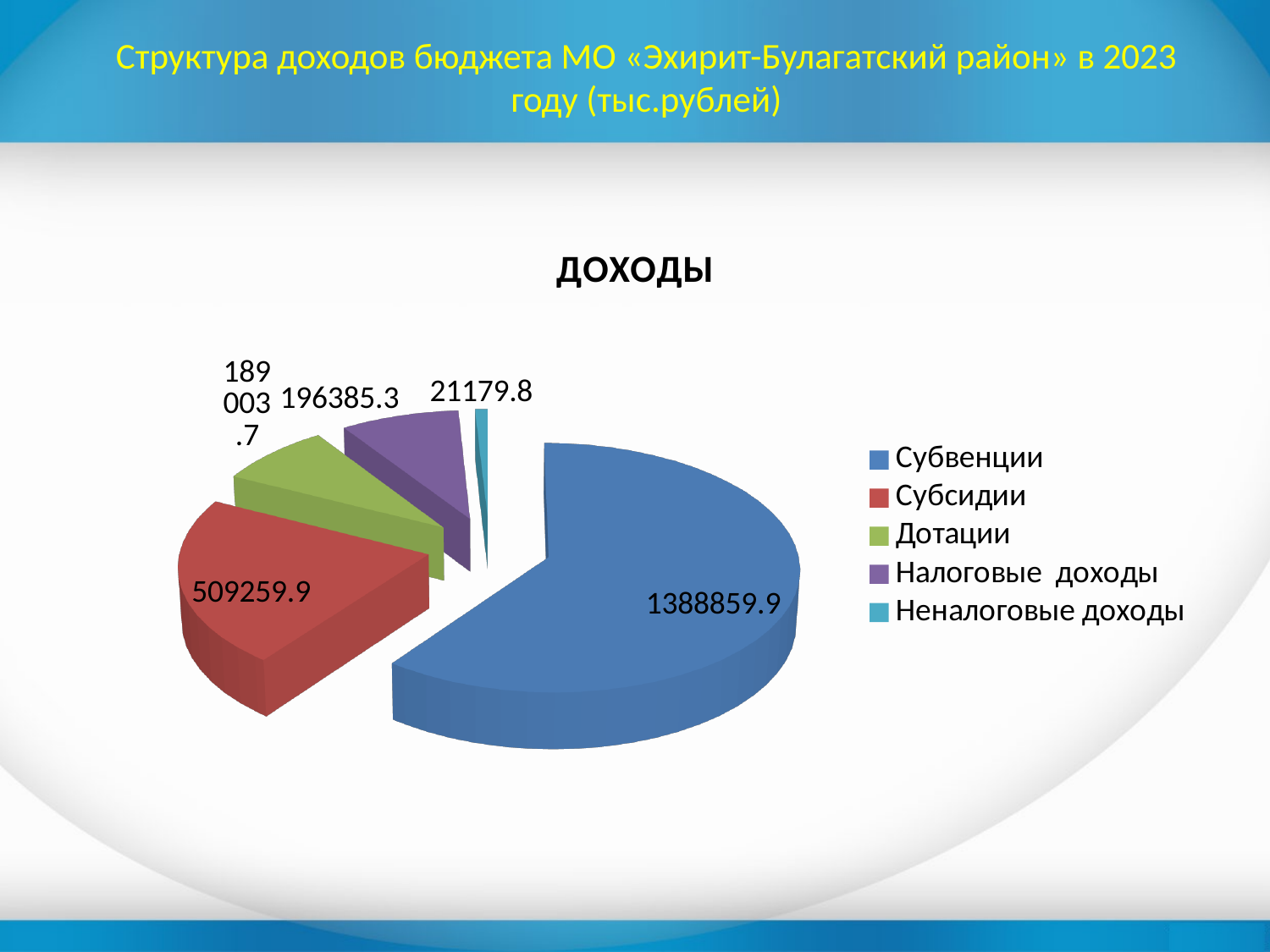
What is the title of the chart? ДОХОДЫ What type of chart is shown on the slide? Pie chart What is the value for Субвенции? 1388859.9 What colour is the slice for Субсидии? Red Which category has the smallest slice? Неналоговые доходы What is the value for Налоговые доходы? 196385.3 What is the value for Субсидии? 509259.9 How many categories does the legend list? 5 Which category has the largest slice? Субвенции What is the difference between Субвенции and Субсидии? 879600.0 What is the value for Неналоговые доходы? 21179.8 Which is larger, Налоговые доходы or Дотации? Налоговые доходы